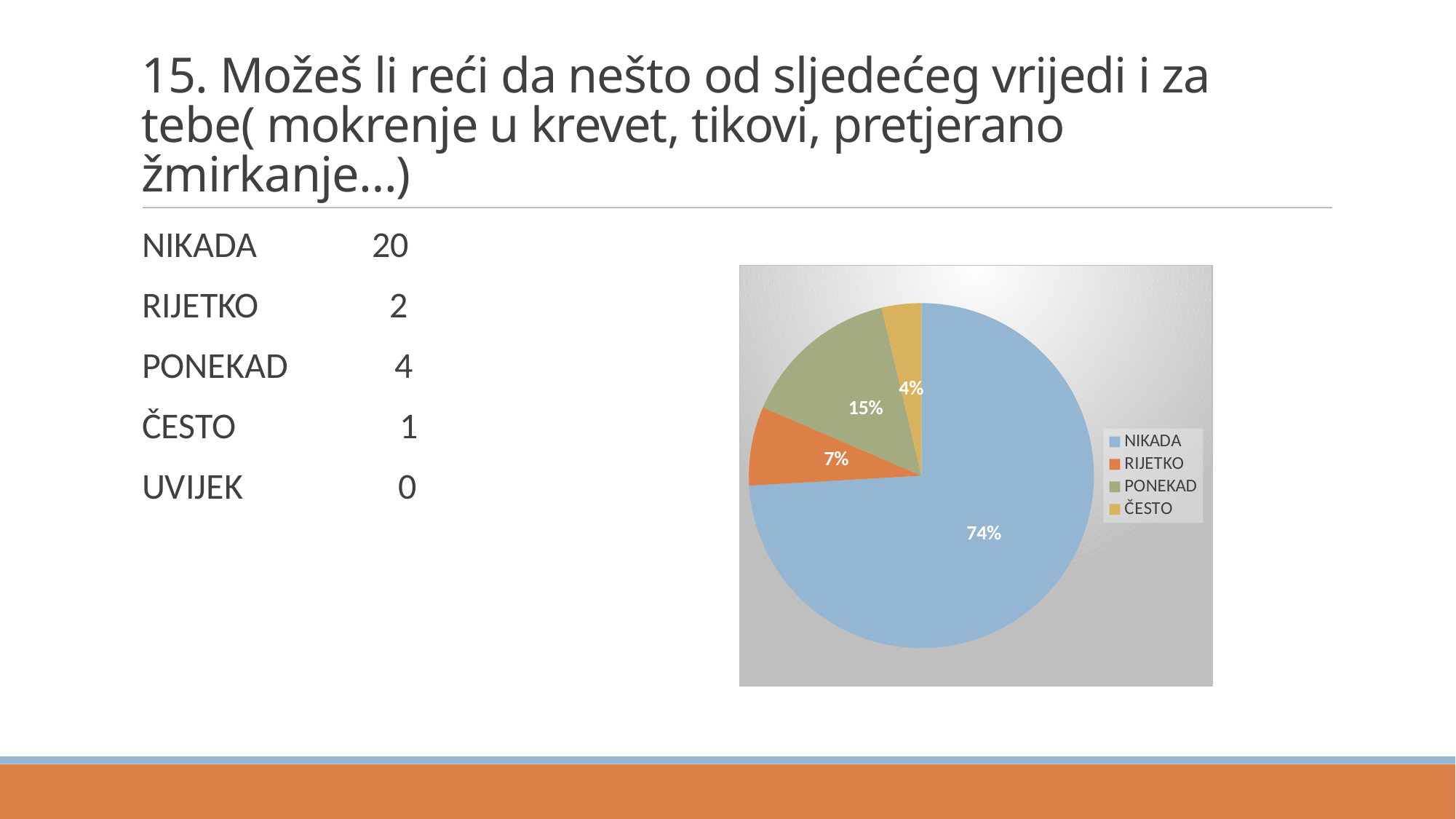
What percentage of the pie chart does RIJETKO represent? 7% What percentage of the pie chart does NIKADA represent? 74% What kind of chart is shown on the slide? pie chart How many categories does the legend of the pie chart list? 4 What percentage of the pie chart does PONEKAD represent? 15% What is the difference in percentage points between the NIKADA slice and the PONEKAD slice? 59 What colour is the NIKADA slice in the pie chart? blue What colour is the RIJETKO slice in the pie chart? orange Which category has the smallest slice in the pie chart? ČESTO Which category has the largest slice in the pie chart? NIKADA Which slice is larger in the pie chart, PONEKAD or RIJETKO? PONEKAD